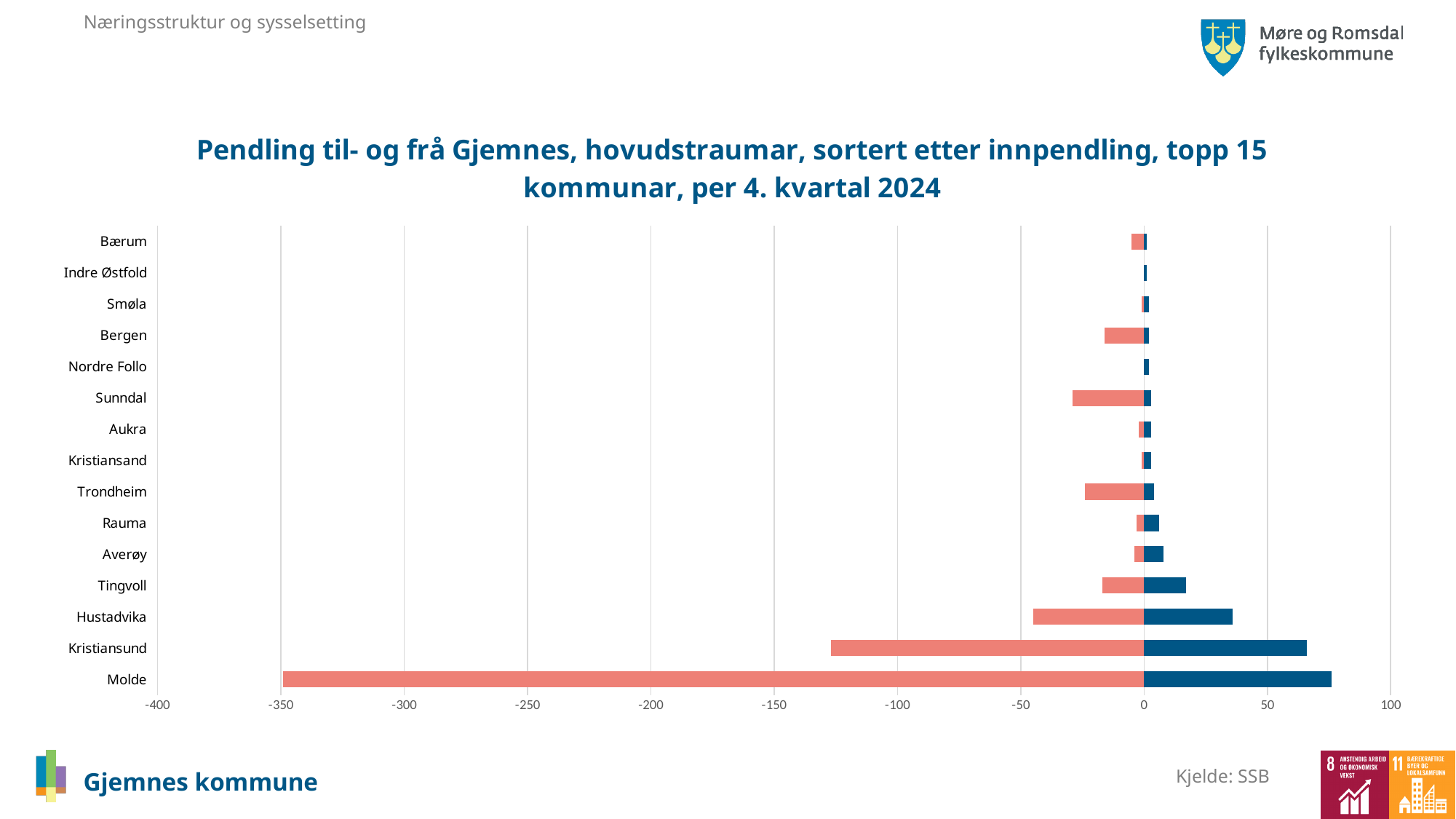
What kind of chart is shown on the slide? bar chart Which has the longer red bar, Sunndal or Aukra? Sunndal Is the red bar for Molde greater or less than -300? less Which has the longer blue bar, Kristiansund or Hustadvika? Kristiansund How many municipalities are listed on the vertical axis of the chart? 15 Is the blue bar for Molde greater or less than 50? greater Which municipality is listed at the bottom of the chart? Molde Is the blue bar for Hustadvika greater or less than 50? less Which municipality has the longest blue (positive) bar? Molde Which municipality has the longest red (negative) bar? Molde